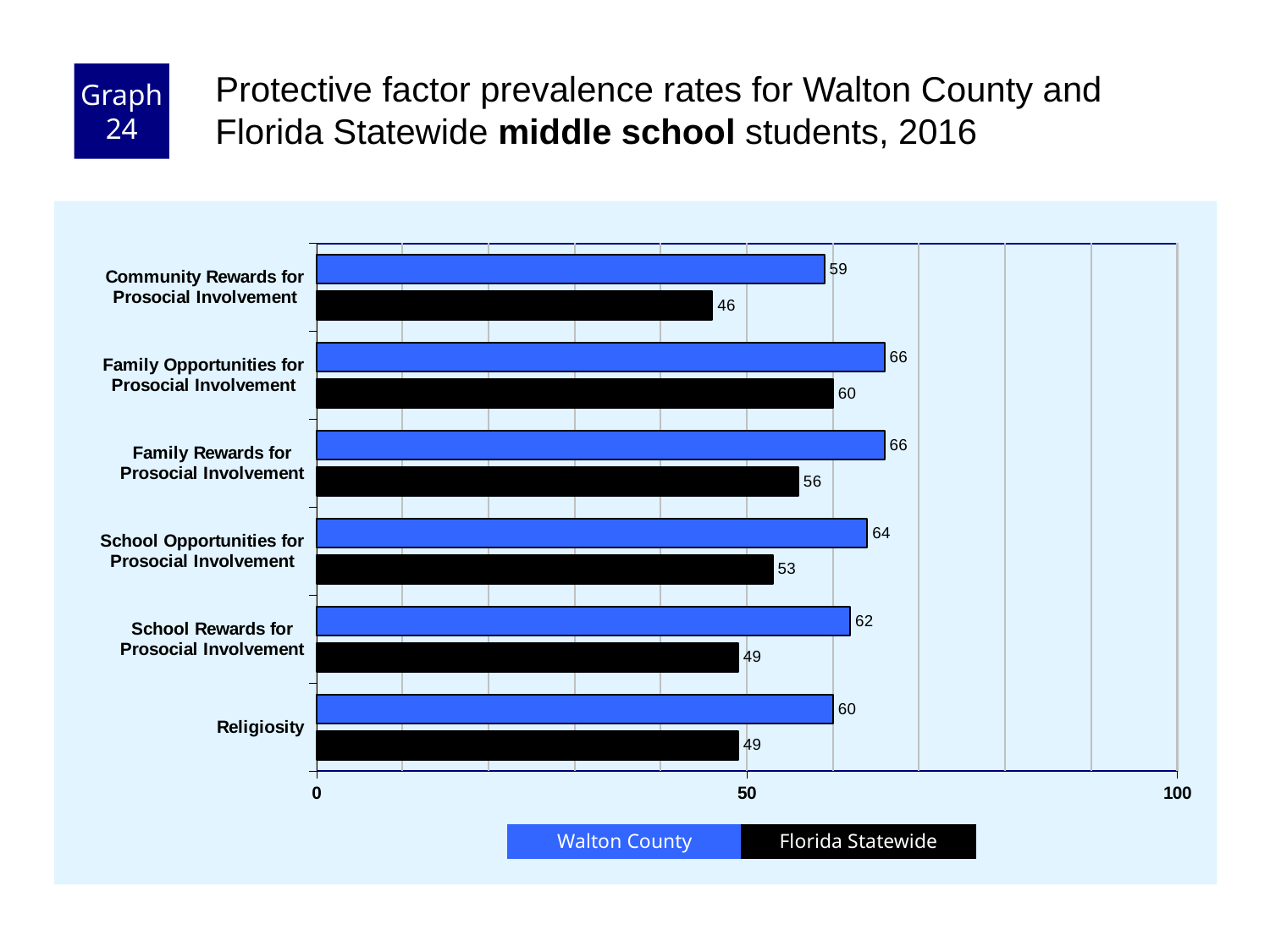
What kind of chart is shown on the slide? bar chart What is the difference between the Walton County and Florida Statewide values for Family Opportunities for Prosocial Involvement? 6 What is the Florida Statewide value for Religiosity? 49 Which is larger for Family Rewards for Prosocial Involvement: the Walton County value or the Florida Statewide value? Walton County Is the Florida Statewide value for Community Rewards for Prosocial Involvement greater or less than 50? less Which category has the lowest Walton County value? Community Rewards for Prosocial Involvement What is the difference between the Walton County and Florida Statewide values for School Rewards for Prosocial Involvement? 13 Which category has the lowest Florida Statewide value? Community Rewards for Prosocial Involvement How many series does the legend list? 2 How many categories are shown on the chart? 6 What is the Walton County value for Community Rewards for Prosocial Involvement? 59 What is the Florida Statewide value for School Opportunities for Prosocial Involvement? 53